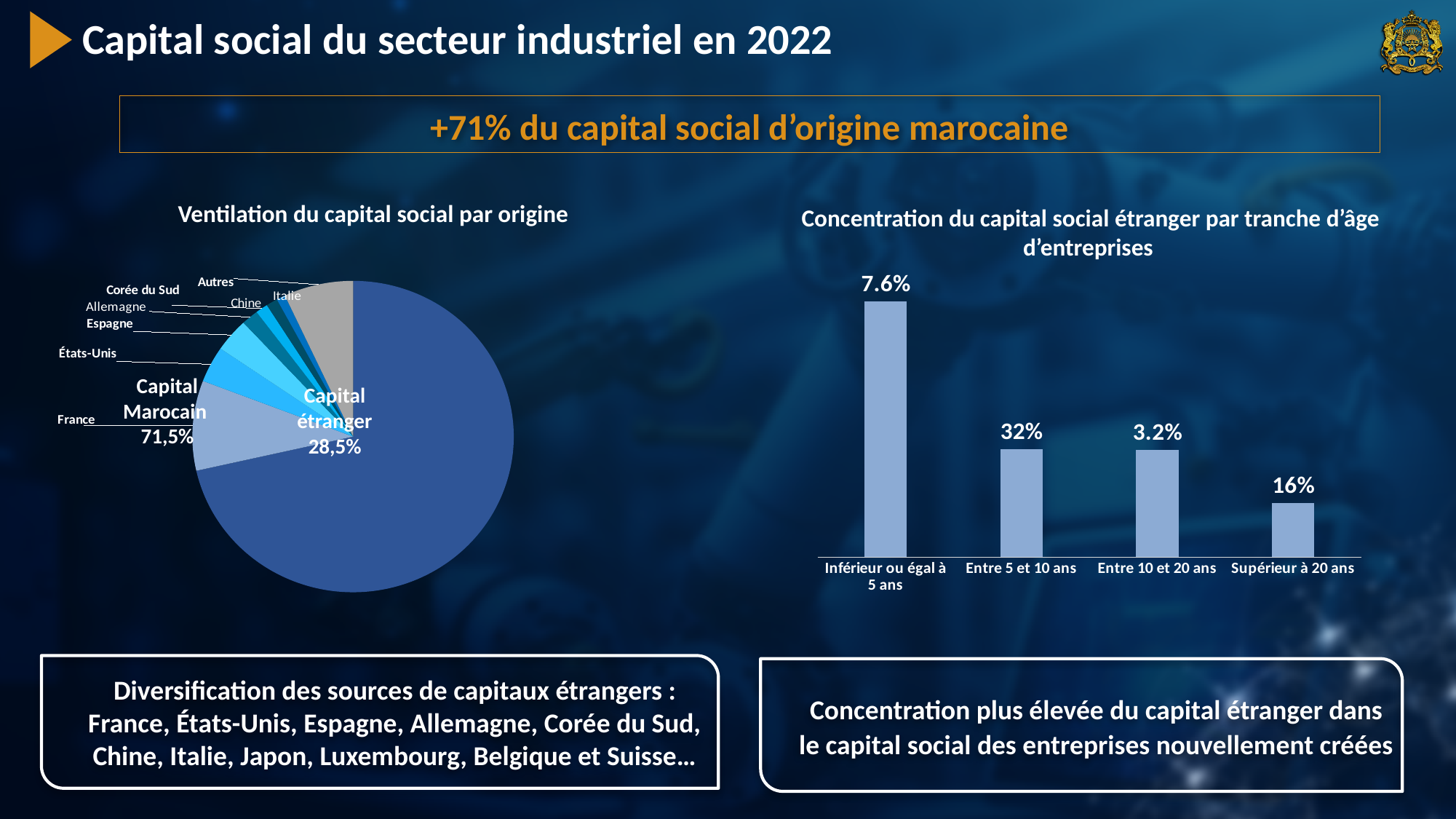
In the pie chart 'Ventilation du capital social par origine', what share is Capital étranger? 28,5% In the bar chart 'Concentration du capital social étranger par tranche d'âge d'entreprises', what value is shown for 'Supérieur à 20 ans'? 16% How many age categories does the bar chart 'Concentration du capital social étranger par tranche d'âge d'entreprises' show? 4 In the bar chart 'Concentration du capital social étranger par tranche d'âge d'entreprises', what value is labelled on the bar for 'Inférieur ou égal à 5 ans'? 7.6% In the pie chart 'Ventilation du capital social par origine', what share is Capital Marocain? 71,5% In the bar chart 'Concentration du capital social étranger par tranche d'âge d'entreprises', which age category has the tallest bar? Inférieur ou égal à 5 ans What kind of chart is 'Ventilation du capital social par origine'? Pie chart In the pie chart 'Ventilation du capital social par origine', what is the difference between the Capital Marocain share and the Capital étranger share? 43% In the bar chart 'Concentration du capital social étranger par tranche d'âge d'entreprises', what value is shown for 'Entre 5 et 10 ans'? 32% In the pie chart 'Ventilation du capital social par origine', which country is the largest source of foreign capital? France In the pie chart 'Ventilation du capital social par origine', which is larger, Capital Marocain or Capital étranger? Capital Marocain What kind of chart is 'Concentration du capital social étranger par tranche d'âge d'entreprises'? Bar chart